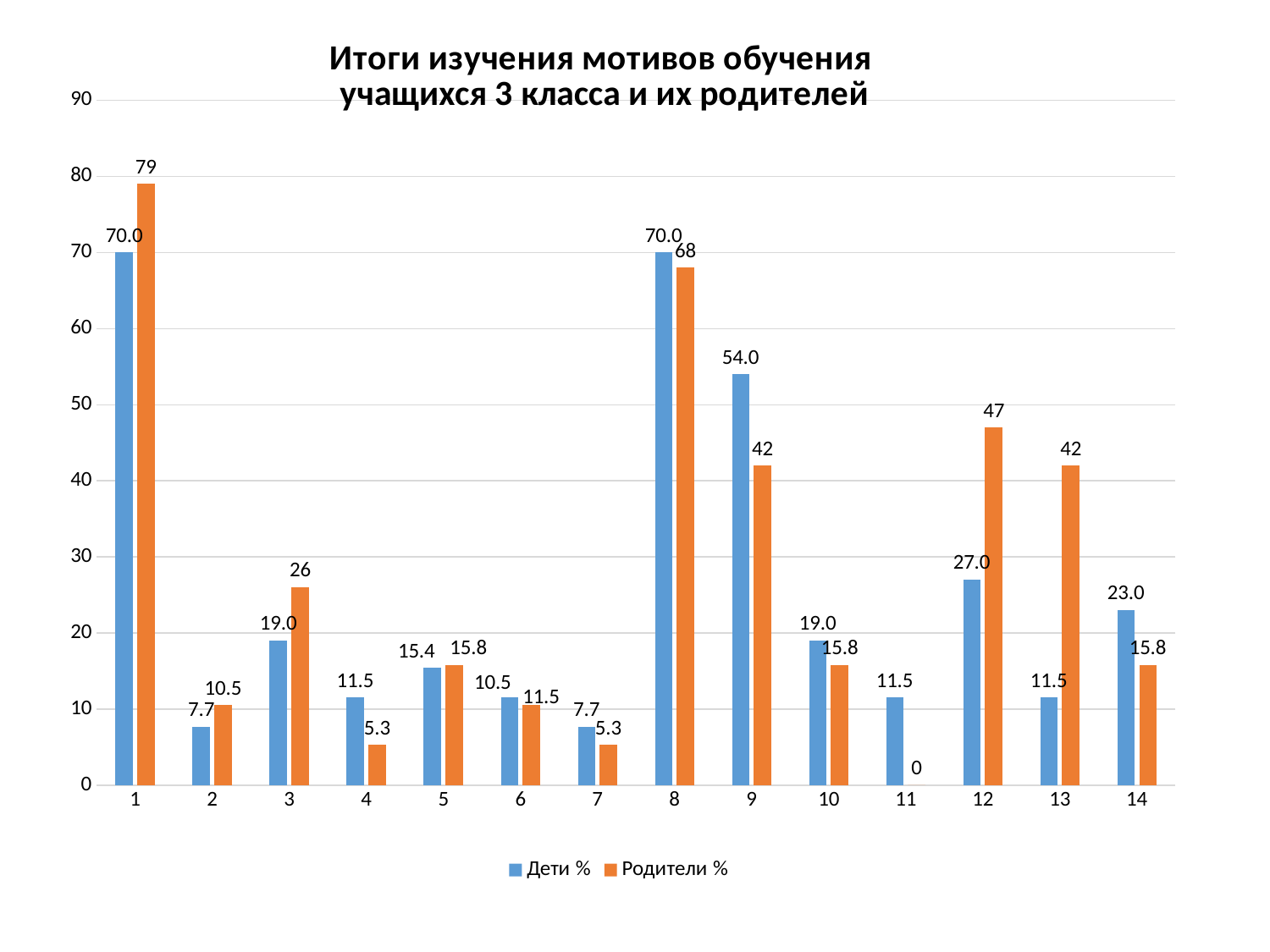
Which category has the lowest value for Родители %? 11 What is the difference between Родители % and Дети % for category 1? 9 What is the value of Дети % for category 9? 54.0 Which category has the highest value for Родители %? 1 What type of chart is shown on the slide? bar chart What is the title of the chart? Итоги изучения мотивов обучения учащихся 3 класса и их родителей What is the difference between Дети % and Родители % for category 13? 30.5 How many series does the legend list? 2 How many categories are shown on the x axis? 14 What is the value of Родители % for category 1? 79 For category 8, which is larger: Дети % or Родители %? Дети % What is the value of Родители % for category 12? 47